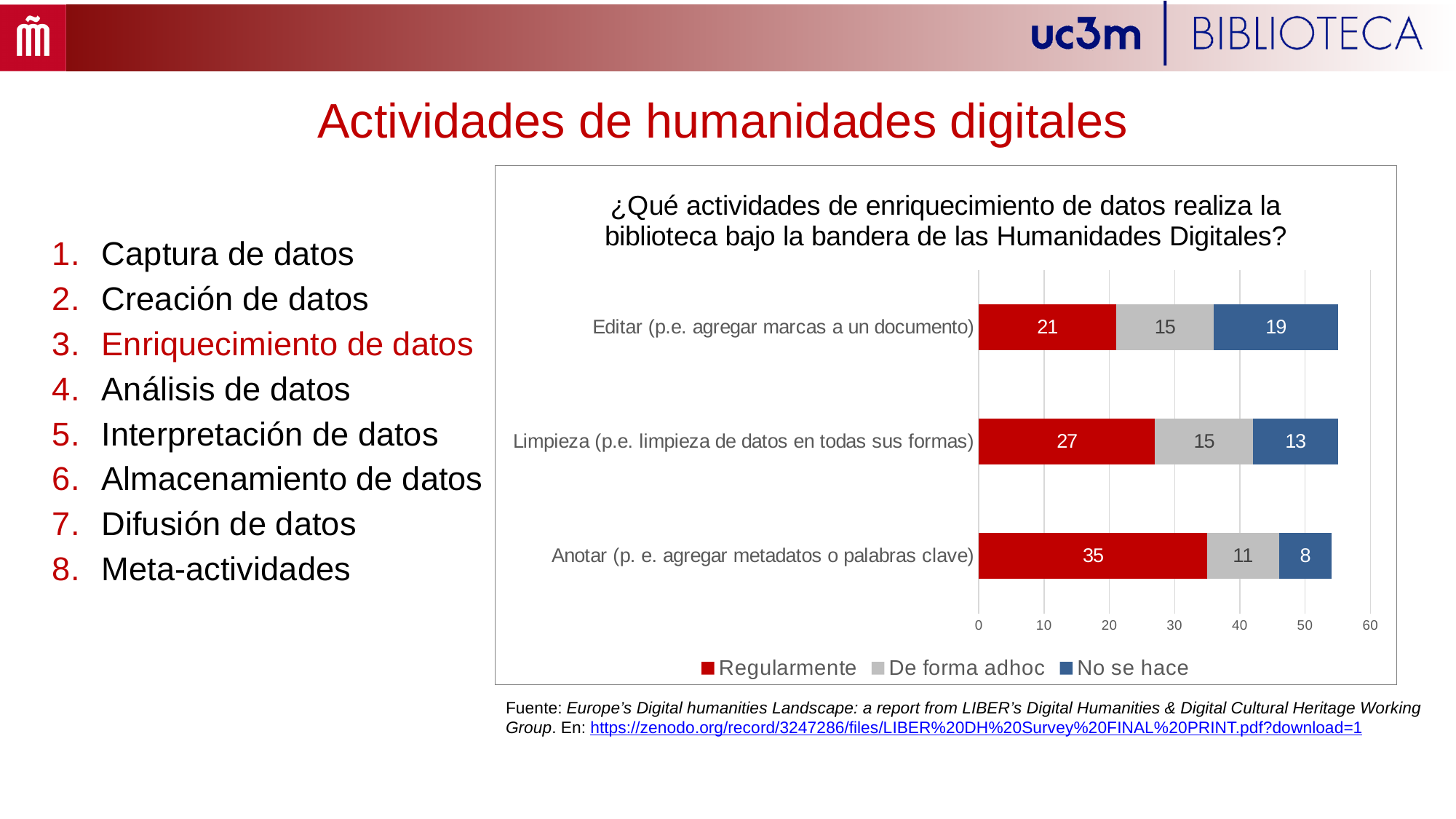
What kind of chart is shown? Stacked bar chart Which category has the highest 'Regularmente' value? Anotar (p. e. agregar metadatos o palabras clave) What is the 'No se hace' value for 'Editar (p.e. agregar marcas a un documento)'? 19 What is the 'Regularmente' value for 'Anotar (p. e. agregar metadatos o palabras clave)'? 35 What is the 'De forma adhoc' value for 'Limpieza (p.e. limpieza de datos en todas sus formas)'? 15 How many categories are shown on the chart? 3 How many series does the legend list? 3 Which category has the lowest 'No se hace' value? Anotar (p. e. agregar metadatos o palabras clave) What is the difference between the 'Regularmente' values for 'Limpieza' and 'Editar'? 6 What is the total of the stacked bar for 'Editar (p.e. agregar marcas a un documento)'? 55 Which is larger: the 'No se hace' value for 'Editar' or for 'Limpieza'? Editar What is the total of the stacked bar for 'Anotar (p. e. agregar metadatos o palabras clave)'? 54